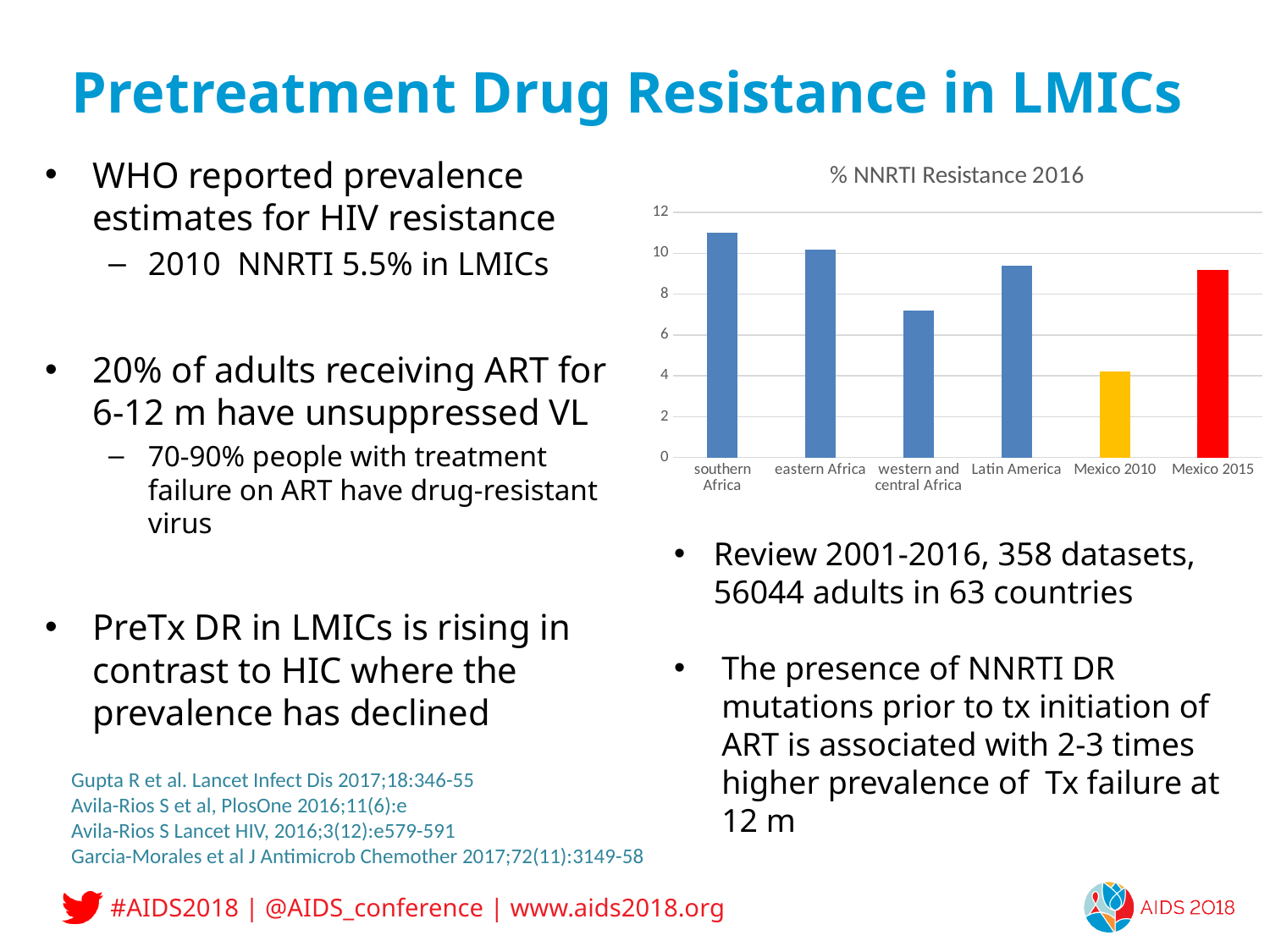
What colour is the bar for Mexico 2015? red Is the value for Mexico 2010 greater or less than 6? less Which is larger, the value for eastern Africa or the value for western and central Africa? eastern Africa How many categories are plotted in the chart? 6 What is the title of the chart? % NNRTI Resistance 2016 Which is larger, the value for Mexico 2010 or the value for Mexico 2015? Mexico 2015 Is the value for western and central Africa greater or less than 8? less Which category has the highest value in the chart? southern Africa Which category has the lowest value in the chart? Mexico 2010 What kind of chart is shown on the slide? bar chart Is the value for Mexico 2015 greater or less than 8? greater